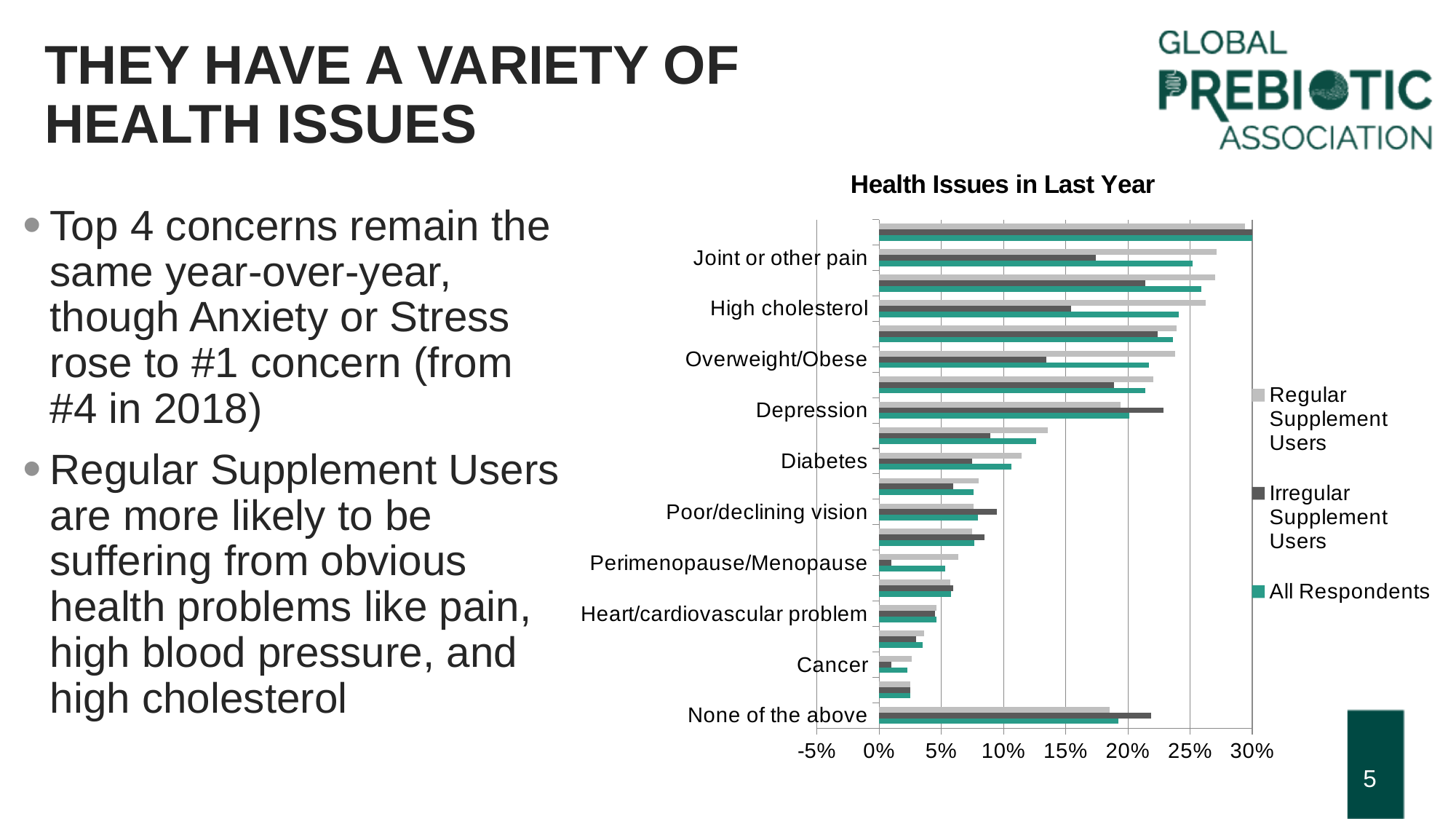
For Joint or other pain, which is larger: the value for Regular Supplement Users or for Irregular Supplement Users? Regular Supplement Users What kind of chart is shown on the slide? bar chart How many series does the legend of the chart list? 3 Is the value for Regular Supplement Users for Joint or other pain greater or less than 25%? greater Is the value for Regular Supplement Users for Heart/cardiovascular problem greater or less than 10%? less What is the title of the chart? Health Issues in Last Year Is the value for All Respondents for Cancer greater or less than 5%? less Which series in the chart is shown in teal/green? All Respondents For None of the above, which is larger: the value for Regular Supplement Users or for Irregular Supplement Users? Irregular Supplement Users